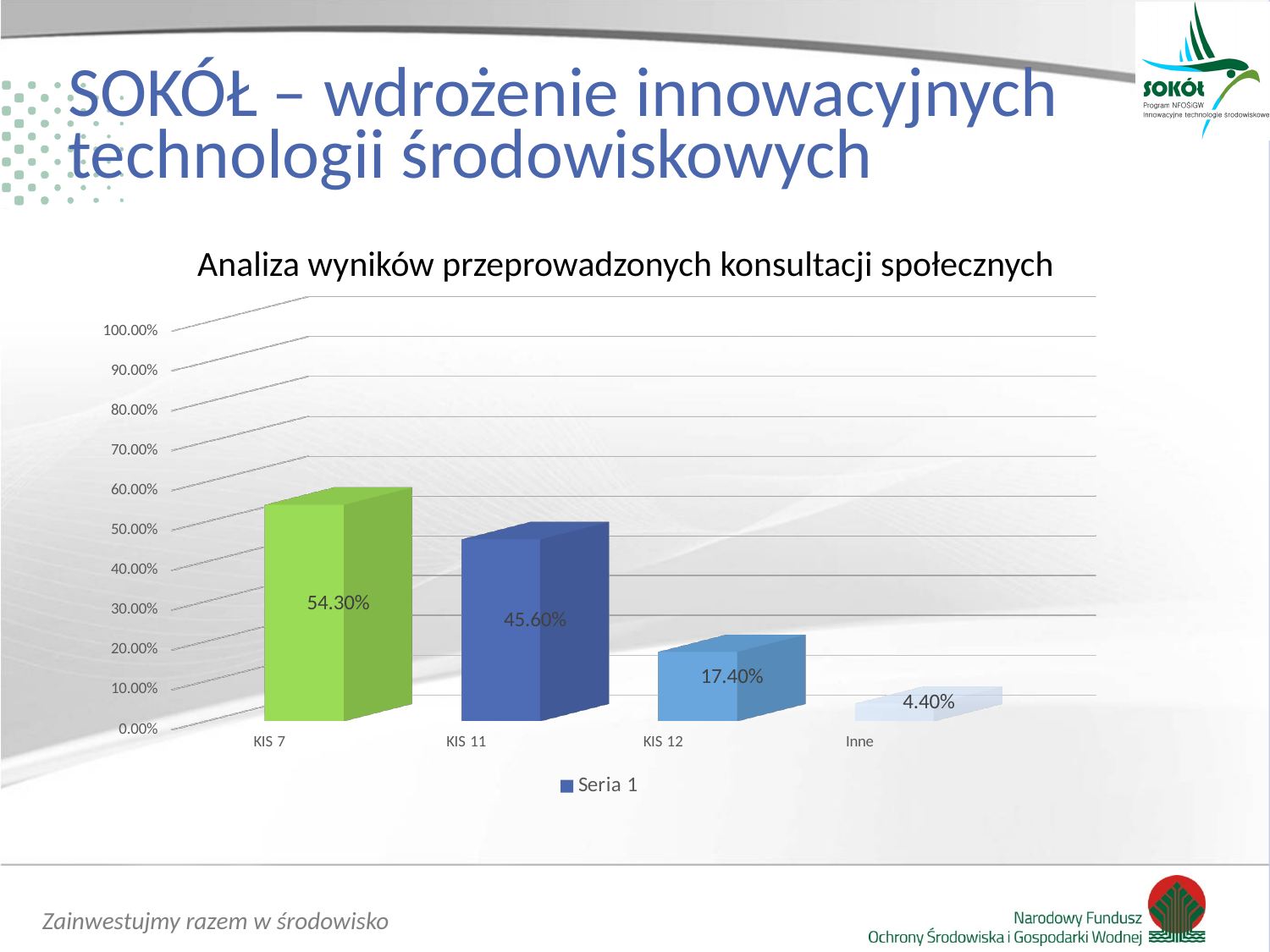
What kind of chart is shown? Bar chart Which is larger, the value for KIS 12 or the value for Inne? KIS 12 What is the value for KIS 11? 45.60% What is the difference between the values for KIS 7 and KIS 11? 8.70% What is the value for Inne? 4.40% Which category has the lowest value? Inne What is the value for KIS 7? 54.30% How many categories are shown on the x axis? 4 What is the value for KIS 12? 17.40% Which category has the highest value? KIS 7 How many series does the legend list? 1 What is the title of the chart? Analiza wyników przeprowadzonych konsultacji społecznych